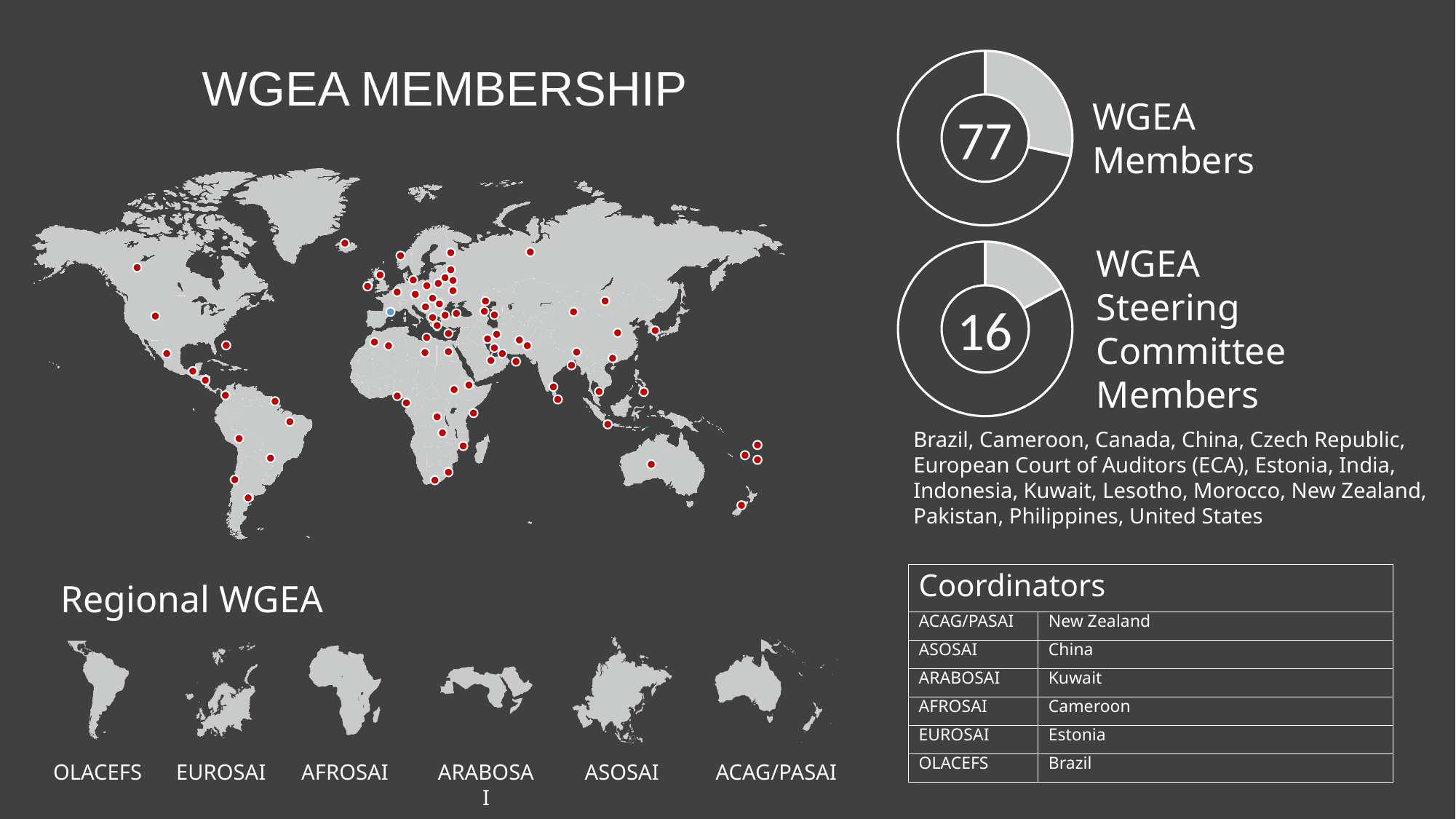
How many donut charts are shown on the slide? 2 What is the label next to the donut chart showing 16? WGEA Steering Committee Members Is the number of WGEA Steering Committee Members greater or less than 20? less What number is shown in the centre of the WGEA Steering Committee Members donut chart? 16 Which is larger, the number of WGEA Members or the number of WGEA Steering Committee Members? WGEA Members What kind of chart is used to display the WGEA Members figure? Donut chart What number is shown in the centre of the WGEA Members donut chart? 77 Which donut chart has the smaller highlighted (light grey) segment, WGEA Members or WGEA Steering Committee Members? WGEA Steering Committee Members Is the number of WGEA Members greater or less than 50? greater What is the difference between the number of WGEA Members (77) and the number of WGEA Steering Committee Members (16)? 61 What is the label next to the donut chart showing 77? WGEA Members